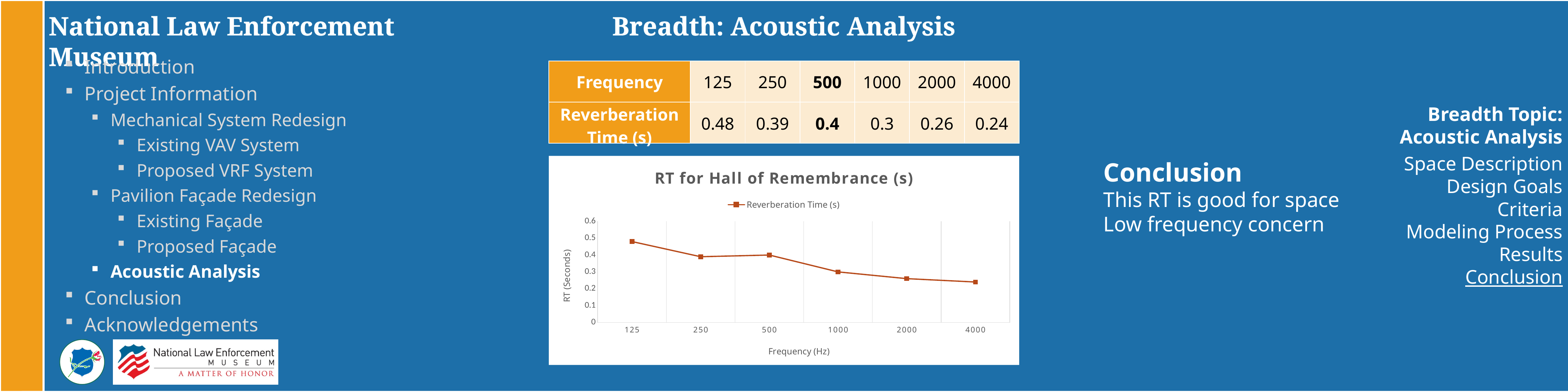
What kind of chart is 'RT for Hall of Remembrance (s)'? line chart Do the reverberation time values generally rise or fall as frequency increases along the x axis? fall At which frequency is the reverberation time highest? 125 What is the title of the chart on the slide? RT for Hall of Remembrance (s) What is the reverberation time at 125 Hz? 0.48 Which has the larger reverberation time, 250 Hz or 1000 Hz? 250 Hz At which frequency is the reverberation time lowest? 4000 What is the reverberation time at 500 Hz? 0.4 How many frequency points are plotted on the chart? 6 What is the reverberation time at 4000 Hz? 0.24 What is the difference between the reverberation time at 125 Hz and at 1000 Hz? 0.18 How many series does the legend of the chart list? 1